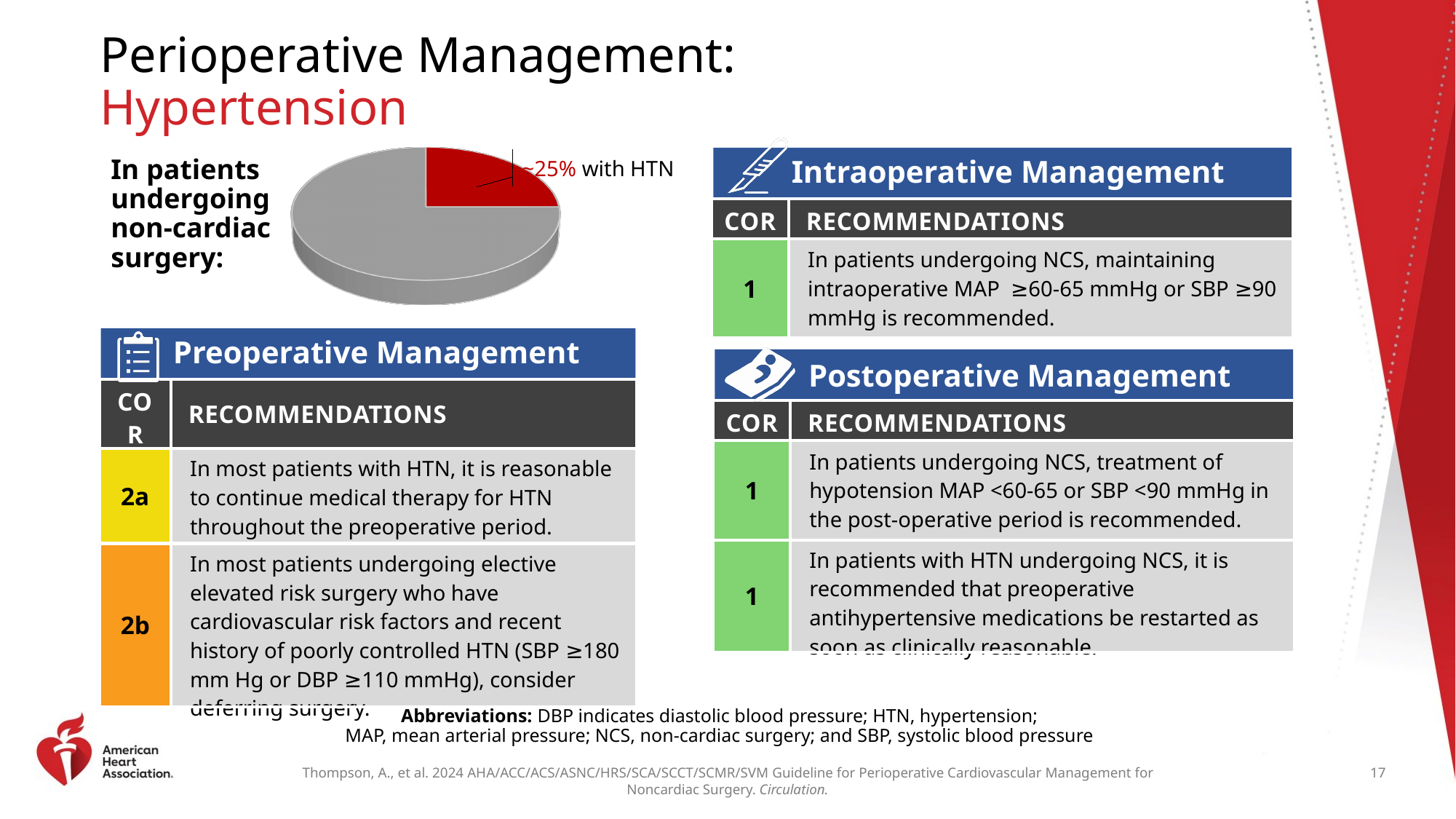
How many slices does the pie chart have? 2 What kind of chart is shown on the slide next to the text 'In patients undergoing non-cardiac surgery:'? pie chart What colour is the slice of the pie chart labelled as patients with HTN? red What is the text of the label attached to the red slice of the pie chart? ~25% with HTN Which slice of the pie chart is the smallest? the red slice (with HTN) Which slice of the pie chart is larger, the red slice (with HTN) or the gray slice? the gray slice Is the share of the pie chart representing patients with HTN greater or less than 50%? less